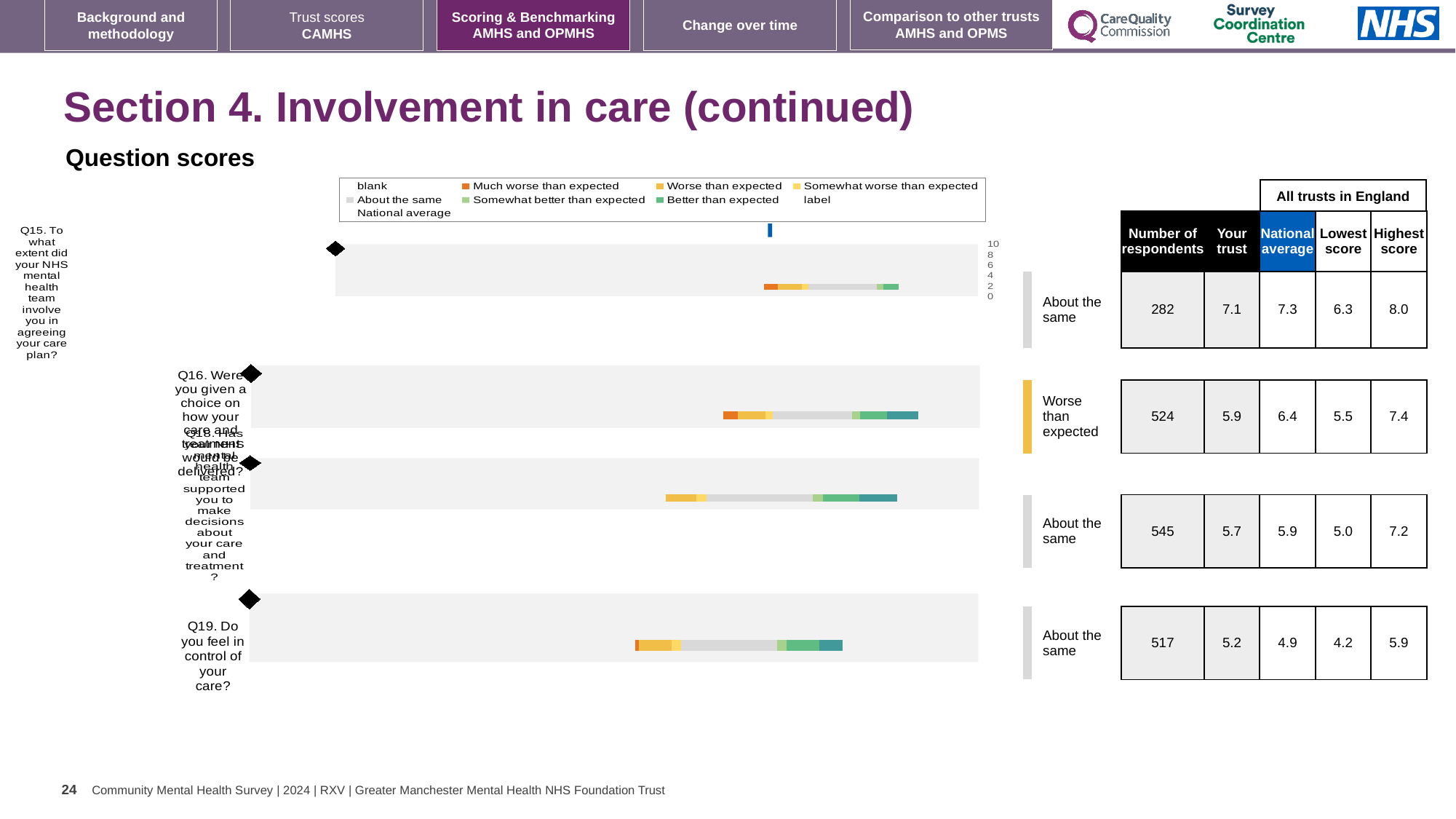
What is the lowest score among all trusts in England for Q18? 5.0 Which question has the lowest 'Your trust' score? Q19 Which question is rated 'Worse than expected' for this trust? Q16 What kind of chart is used to show the question scores on this slide? bar chart What is the highest score among all trusts in England for Q19 (do you feel in control of your care)? 5.9 How many respondents answered Q18 (mental health team supported you to make decisions about your care and treatment)? 545 What is the difference between the national average and the 'Your trust' score for Q15? 0.2 In the question scores table, what is the 'Your trust' score for Q15 (involvement in agreeing your care plan)? 7.1 Which question has the highest 'Your trust' score? Q15 How many questions (Q15, Q16, Q18, Q19) are plotted in the question scores chart? 4 In the question scores table, what is the national average for Q16 (given a choice on how care and treatment would be delivered)? 6.4 For Q19, which is larger: the 'Your trust' score or the national average? Your trust